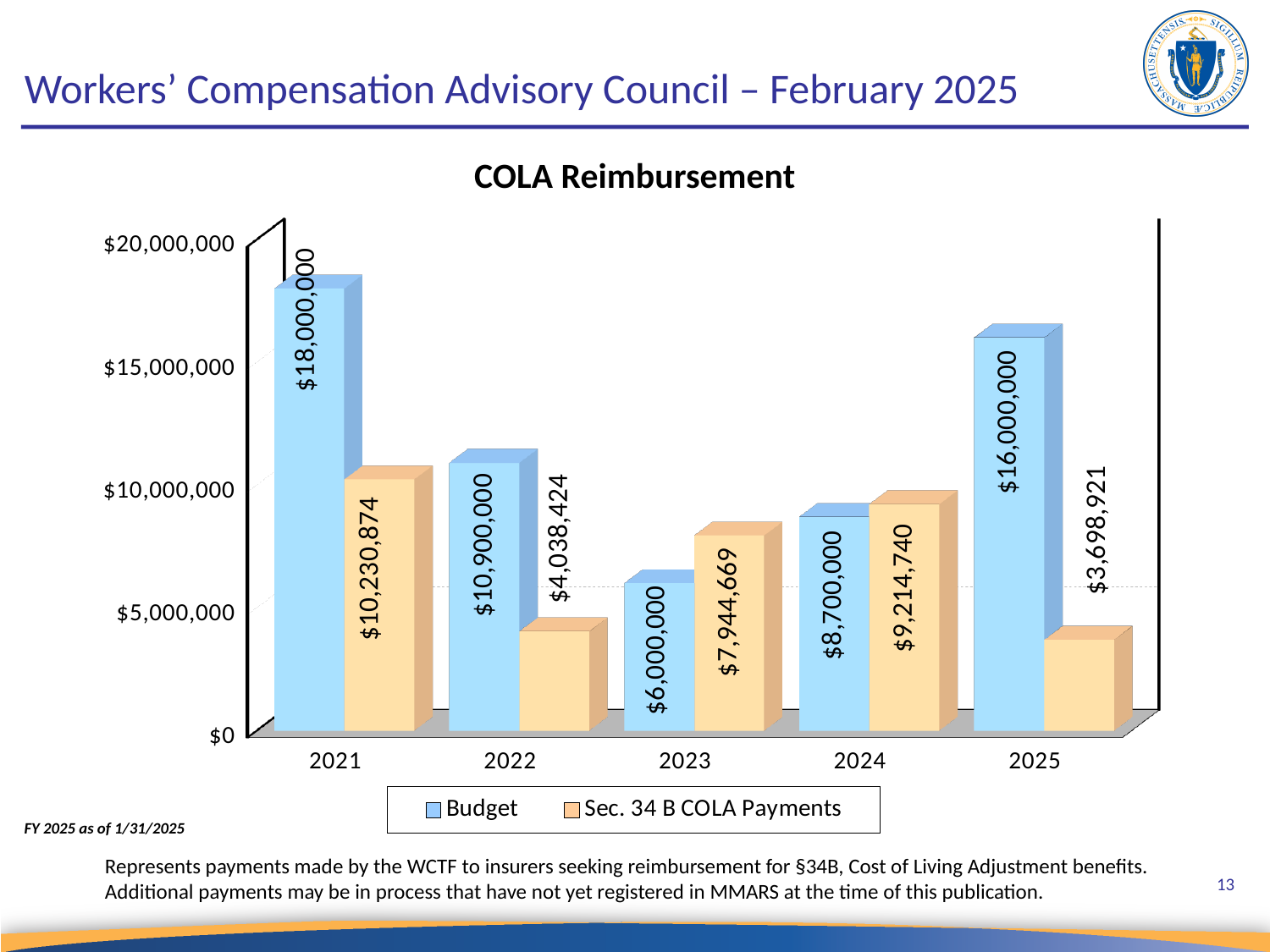
In the COLA Reimbursement chart, what is the Sec. 34 B COLA Payments value for 2025? $3,698,921 In the COLA Reimbursement chart, what is the difference between the Sec. 34 B COLA Payments and the Budget for 2024? $514,740 In the COLA Reimbursement chart, what is the Sec. 34 B COLA Payments value for 2023? $7,944,669 In the COLA Reimbursement chart, which is larger for 2023: the Budget or the Sec. 34 B COLA Payments? Sec. 34 B COLA Payments In the COLA Reimbursement chart, which year has the highest Budget value? 2021 How many series does the legend of the COLA Reimbursement chart list? 2 How many years are shown on the x axis of the COLA Reimbursement chart? 5 What kind of chart is the COLA Reimbursement chart? Bar chart In the COLA Reimbursement chart, which year has the lowest Budget value? 2023 In the COLA Reimbursement chart, what is the Budget value for 2021? $18,000,000 In the COLA Reimbursement chart, what is the difference between the Budget and the Sec. 34 B COLA Payments for 2021? $7,769,126 In the COLA Reimbursement chart, which year has the lowest Sec. 34 B COLA Payments value? 2025